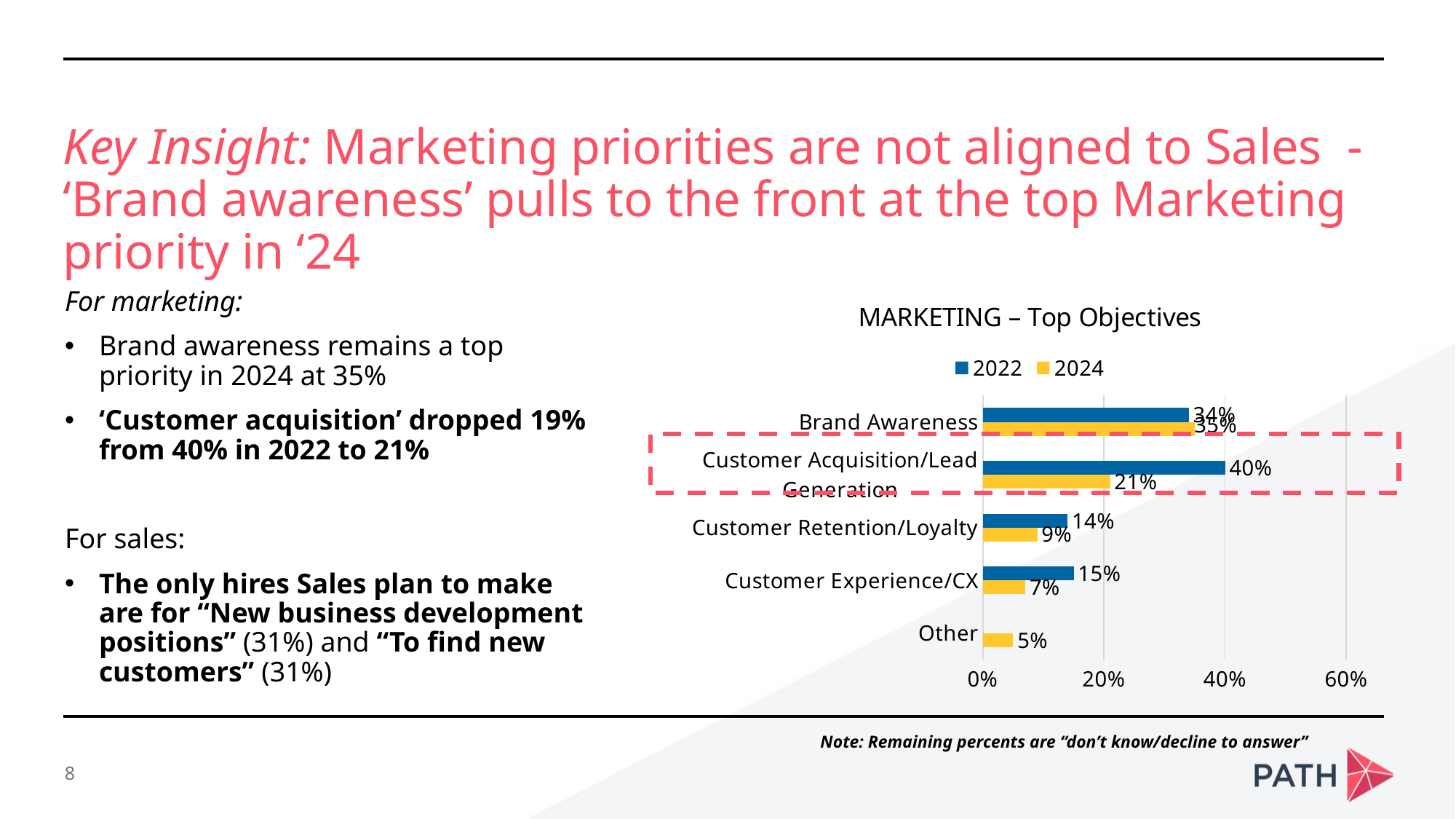
What is the 2022 value for Customer Experience/CX? 15% What is the difference between the 2022 and 2024 values for Customer Acquisition/Lead Generation? 19% What type of chart is shown on the slide? bar chart How many series does the chart legend list? 2 What is the 2024 value for Other? 5% How many categories are shown on the chart? 5 Which category has the highest 2022 value? Customer Acquisition/Lead Generation What is the title of the chart? MARKETING – Top Objectives Which category has the lowest 2024 value? Other What is the 2024 value for Customer Acquisition/Lead Generation? 21% What is the 2024 value for Customer Retention/Loyalty? 9% What is the 2022 value for Customer Acquisition/Lead Generation? 40%